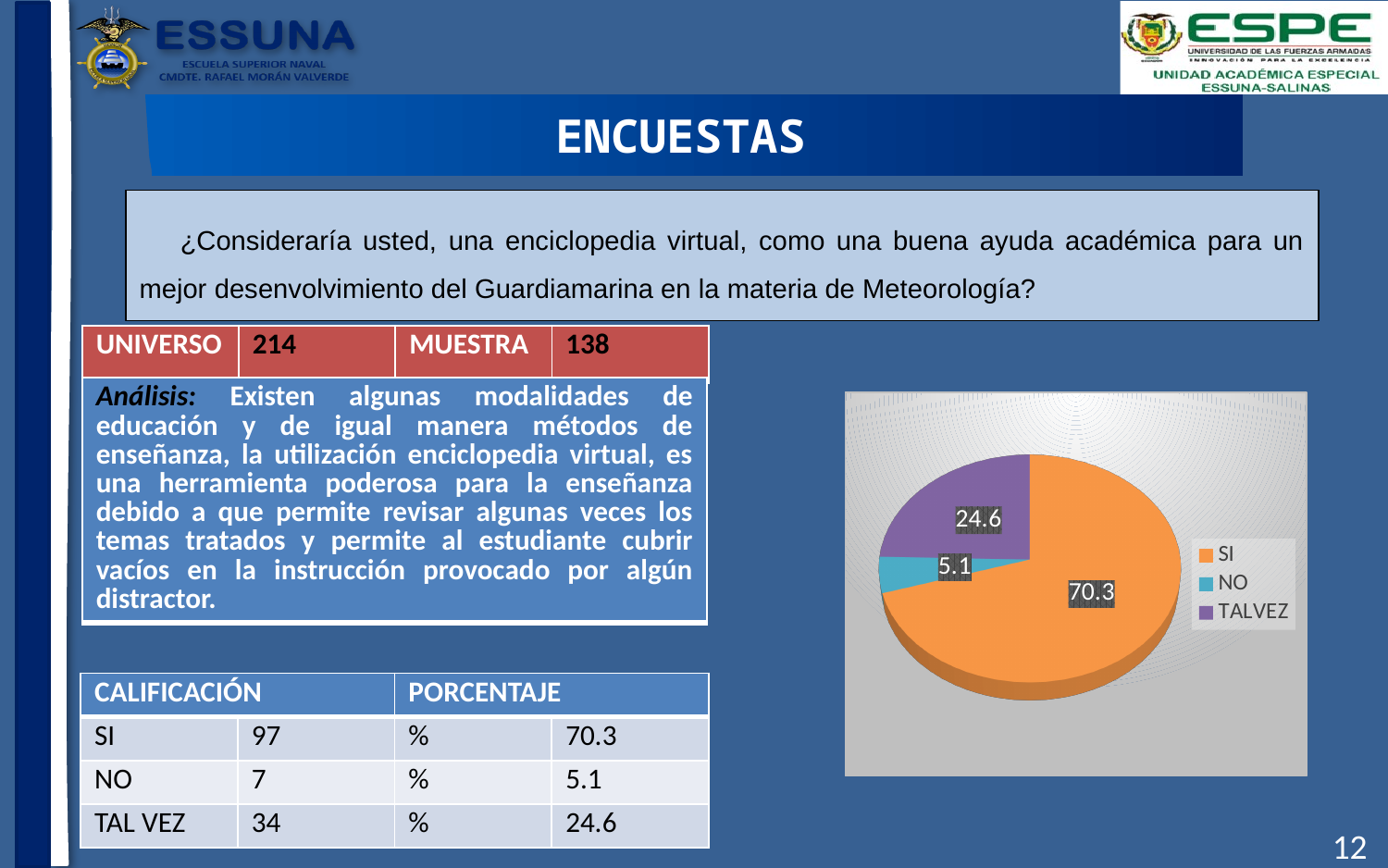
What is the difference between the SI and TALVEZ values in the pie chart? 45.7 What is the value shown for the SI slice of the pie chart? 70.3 What colour is the SI slice in the pie chart? orange What is the value shown for the TALVEZ slice of the pie chart? 24.6 What is the value shown for the NO slice of the pie chart? 5.1 How many entries does the legend of the pie chart list? 3 What is the difference between the TALVEZ and NO values in the pie chart? 19.5 Which category has the largest slice in the pie chart? SI What kind of chart is shown on the slide? pie chart How many slices does the pie chart have? 3 Which is larger in the pie chart, the TALVEZ slice or the NO slice? TALVEZ Which category has the smallest slice in the pie chart? NO